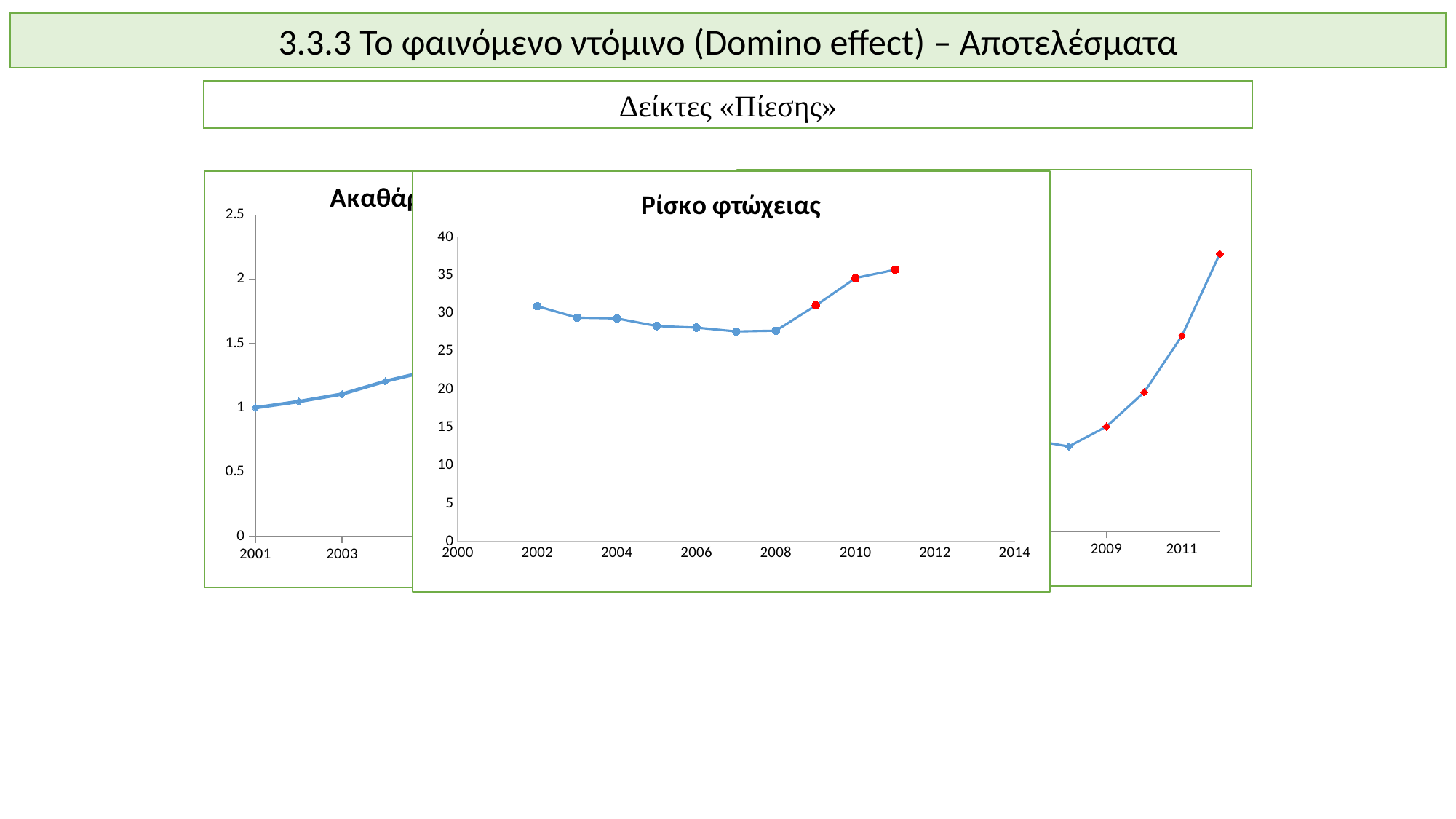
In the "Ρίσκο φτώχειας" chart, do the values rise or fall from 2008 to 2011? rise In the "Ρίσκο φτώχειας" chart, what is the highest value shown on the vertical axis? 40 What kind of chart is the "Ρίσκο φτώχειας" chart? line chart In the chart on the left of the slide, is the value for 2001 greater or less than 1.5? less In the "Ρίσκο φτώχειας" chart, is the value for 2011 greater or less than 30? greater In the "Ρίσκο φτώχειας" chart, is the value for 2007 greater or less than 30? less In the chart on the right of the slide, do the values rise or fall from 2009 onward? rise In the "Ρίσκο φτώχειας" chart, which is larger, the value for 2002 or the value for 2007? 2002 How many data points are plotted in the "Ρίσκο φτώχειας" chart? 10 In the "Ρίσκο φτώχειας" chart, which year has the highest value? 2011